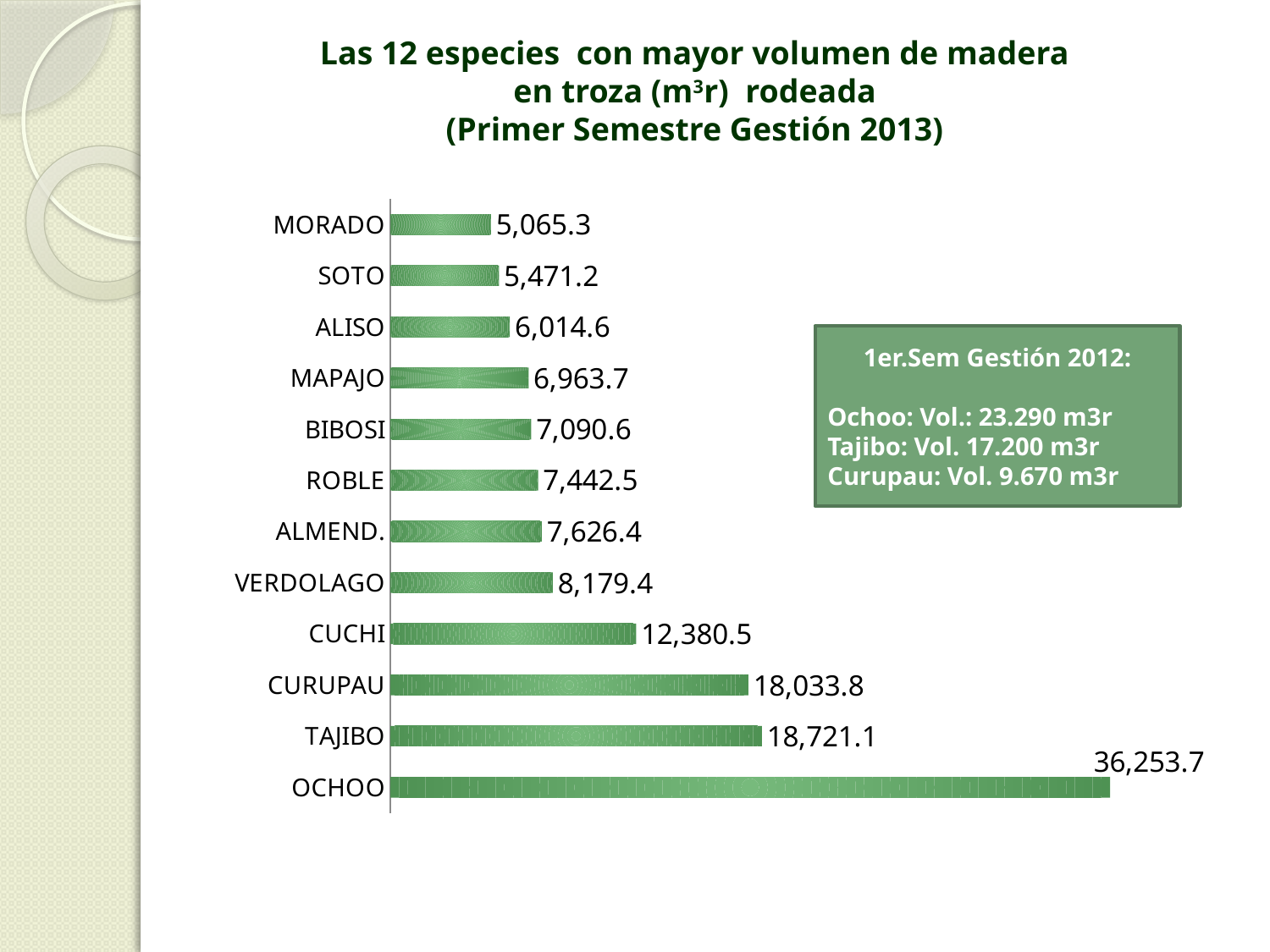
What is the difference between the values for OCHOO and TAJIBO? 17,532.6 How many species are shown in the chart? 12 Which species has the lowest value? MORADO Which species has the highest value? OCHOO What is the value for MAPAJO? 6,963.7 What kind of chart is shown on the slide? Bar chart What is the value for CUCHI? 12,380.5 What is the value for OCHOO? 36,253.7 Which is larger, the value for SOTO or the value for ALISO? ALISO According to the text box, what was the volume for Ochoo in the first semester of 2012? 23.290 m3r Which is larger, the value for VERDOLAGO or the value for ALMEND.? VERDOLAGO What is the difference between the values for TAJIBO and CURUPAU? 687.3